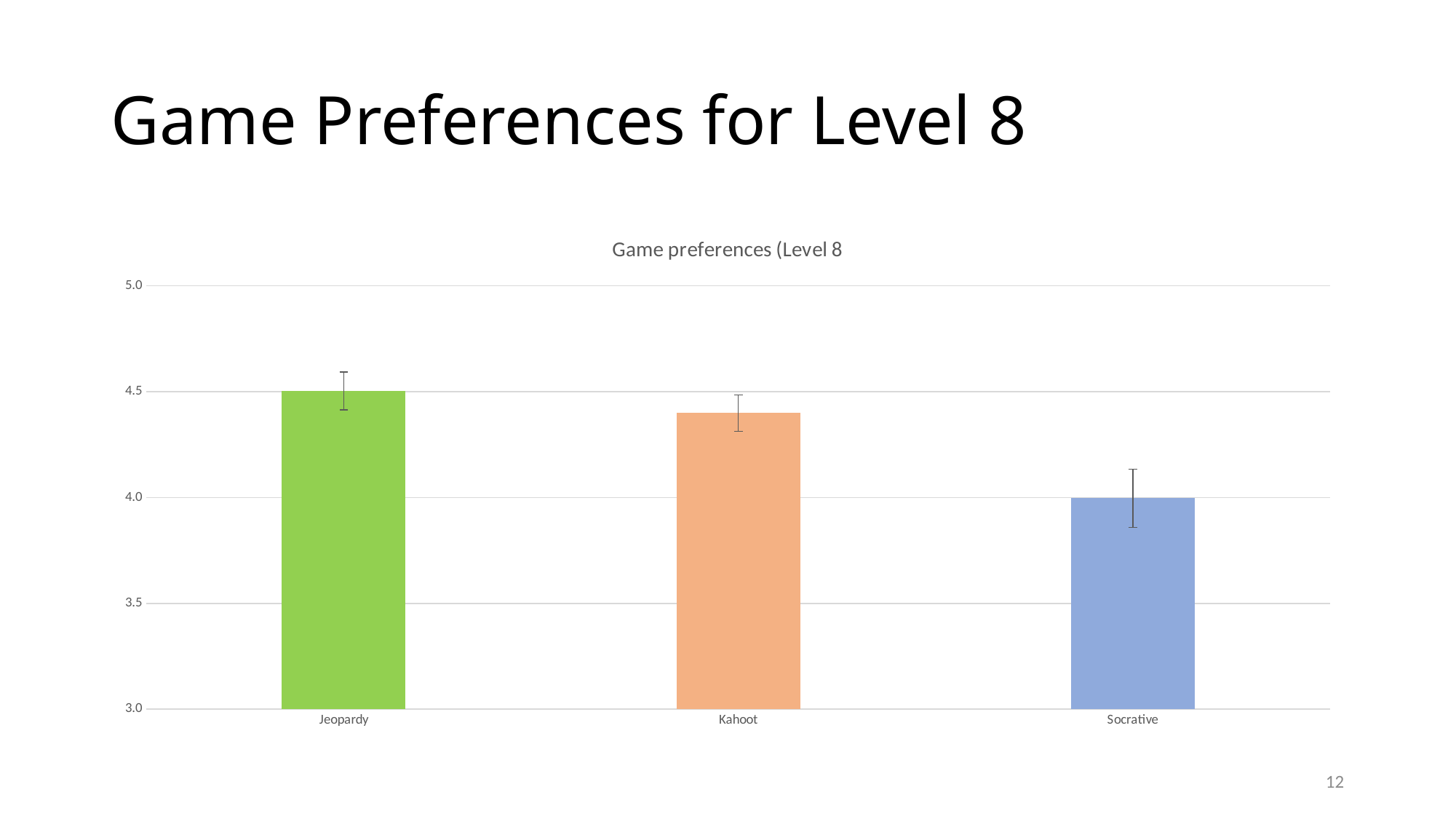
Which game has the lowest preference value? Socrative Which is larger, the value for Kahoot or the value for Socrative? Kahoot What is the difference between the values for Jeopardy and Socrative? 0.5 What colour is the bar for Socrative? blue Is the value for Kahoot greater or less than 4.0? greater What kind of chart is shown on the slide? bar chart What is the title of the chart? Game preferences (Level 8 Is the value for Kahoot greater or less than 4.5? less Which game has the highest preference value? Jeopardy What is the preference value for Jeopardy? 4.5 What is the preference value for Socrative? 4.0 How many games (categories) are plotted in the chart? 3